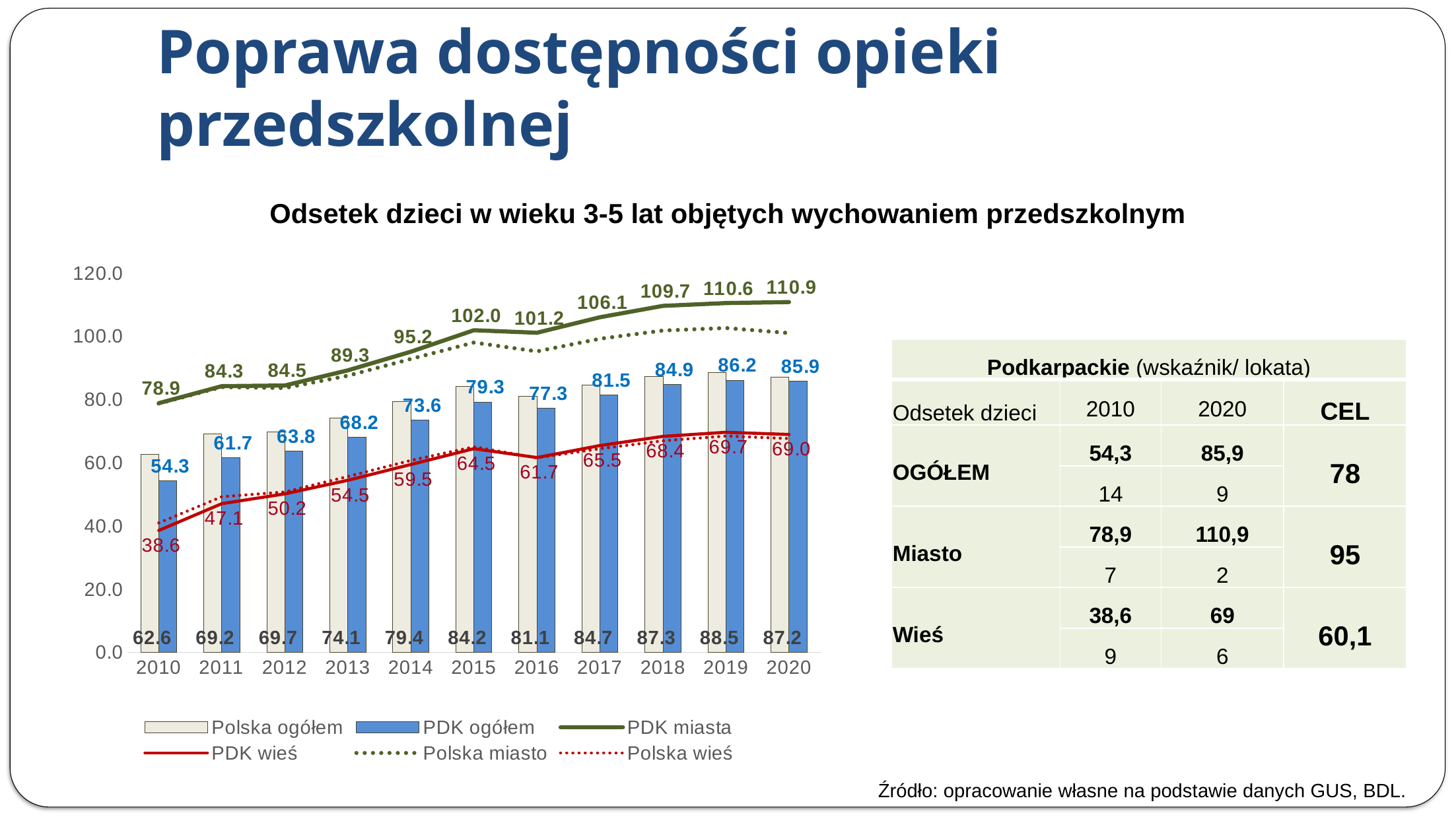
What is the value of PDK ogółem in 2020? 85.9 In which year is PDK ogółem lowest? 2010 What is the value of PDK miasta in 2017? 106.1 What is the difference between Polska ogółem and PDK ogółem in 2010? 8.3 Does PDK wieś generally rise or fall from 2010 to 2020? Rise How many years are shown on the x axis? 11 How many series does the legend list? 6 What is the value of PDK wieś in 2010? 38.6 What is the value of Polska ogółem in 2015? 84.2 What kind of chart is shown on the slide? Combined bar and line chart Which is larger in 2019: Polska ogółem or PDK ogółem? Polska ogółem In which year is PDK miasta highest? 2020